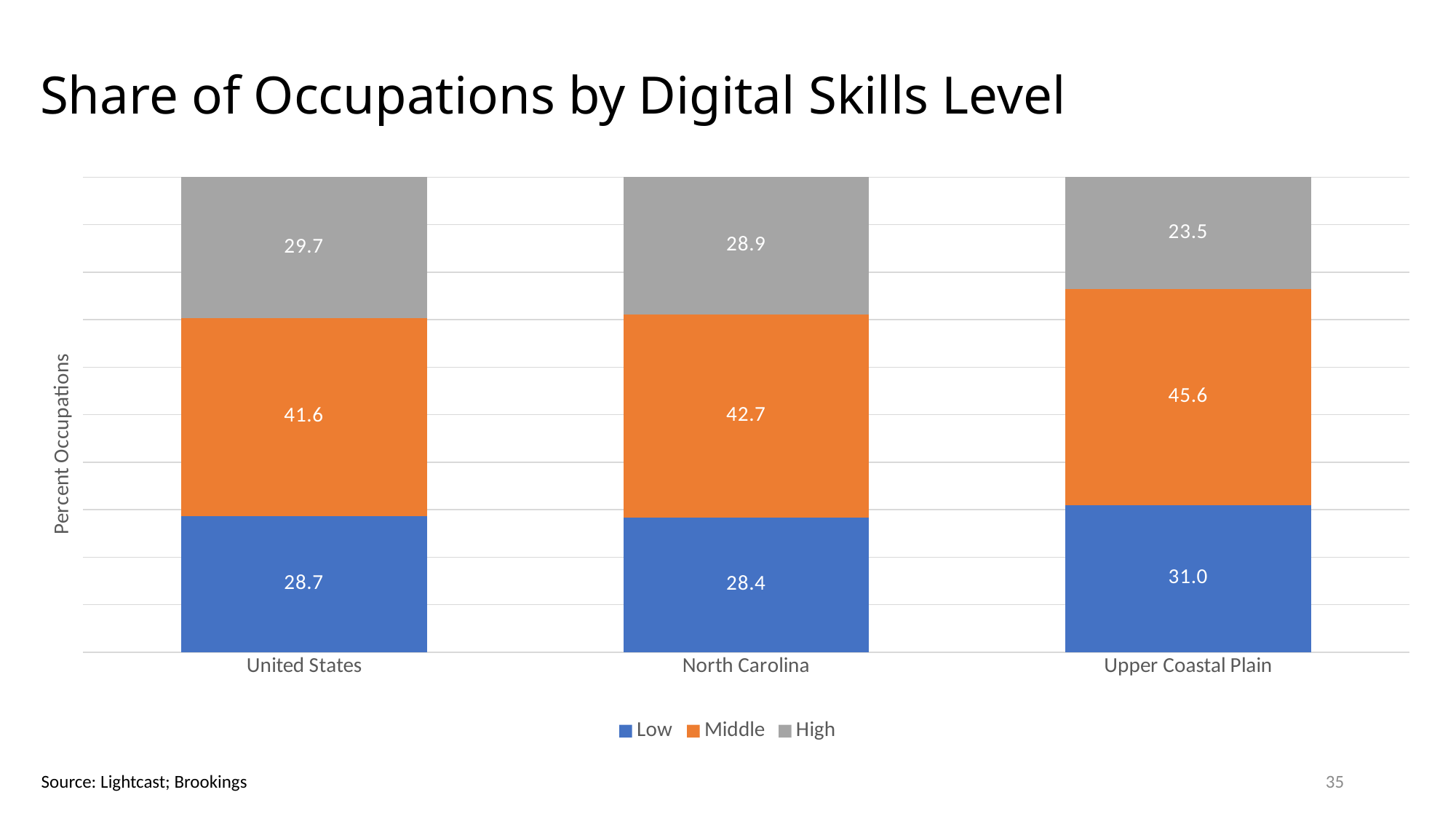
Which category has the highest Middle value? Upper Coastal Plain How many categories are shown on the x axis? 3 How many series does the legend list? 3 What is the Low value for United States? 28.7 Which is larger, the Low value for Upper Coastal Plain or the Low value for North Carolina? Upper Coastal Plain What is the difference between the High values for United States and Upper Coastal Plain? 6.2 What kind of chart is shown on the slide? Stacked bar chart What is the total of the stacked bar for North Carolina? 100.0 What is the Middle value for Upper Coastal Plain? 45.6 What is the title of the chart? Share of Occupations by Digital Skills Level What is the High value for North Carolina? 28.9 Which category has the lowest High value? Upper Coastal Plain